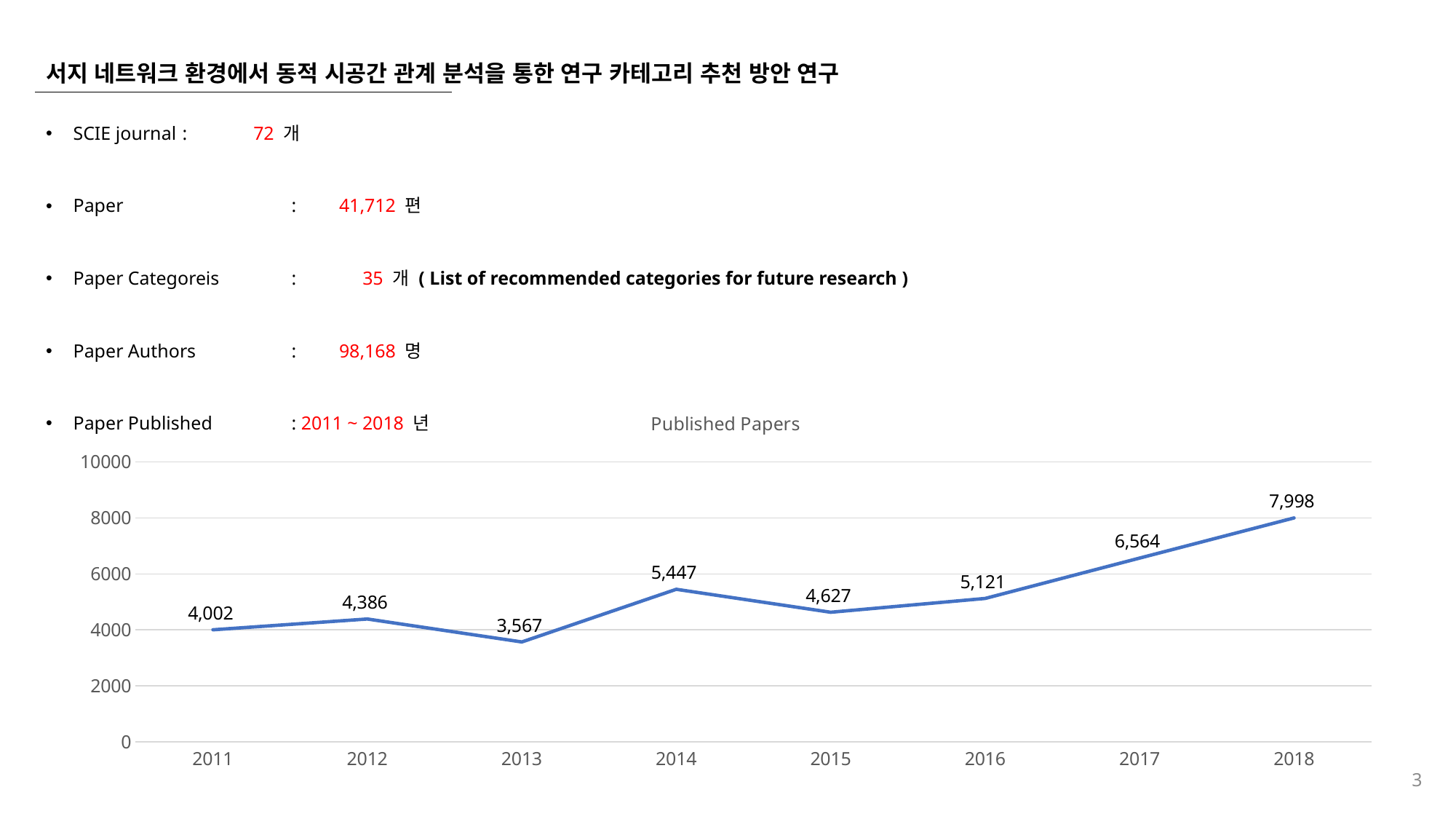
Which is larger, the value for 2014 or the value for 2016? 2014 What is the value for 2017 in the Published Papers chart? 6,564 What is the difference between the values for 2018 and 2017? 1,434 How many years are plotted in the Published Papers chart? 8 What is the title of the chart? Published Papers Which year has the highest number of published papers? 2018 What is the value for 2011 in the Published Papers chart? 4,002 What is the difference between the values for 2014 and 2013? 1,880 What kind of chart is shown on the slide? line chart Which year has the lowest number of published papers? 2013 Is the value for 2018 greater or less than 6000? greater What is the value for 2015 in the Published Papers chart? 4,627